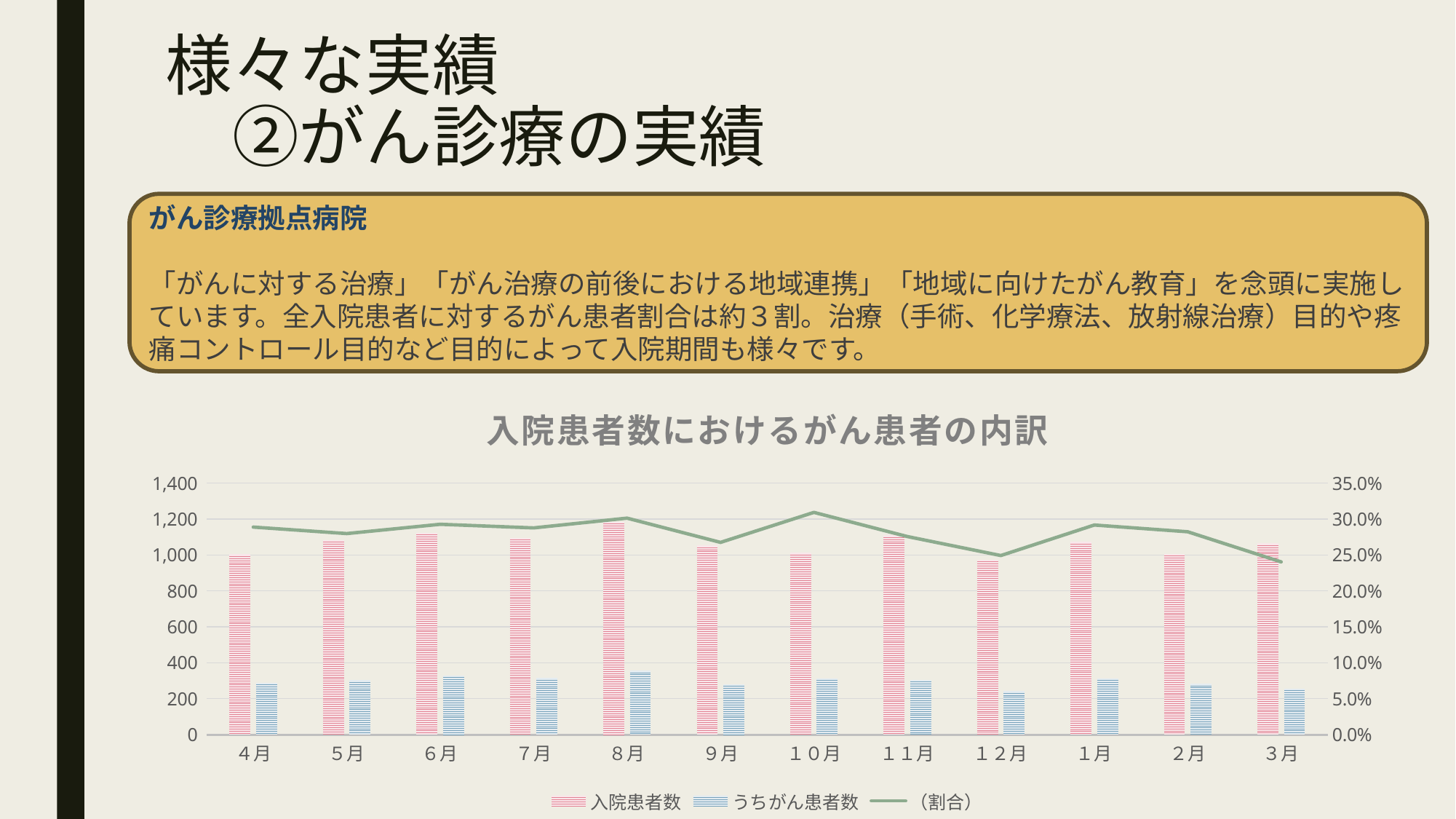
Which month has the larger 入院患者数, 8月 or 12月? 8月 In which month is the （割合） line highest? 10月 How many series does the chart legend list? 3 Which series in the chart is drawn as a line rather than bars? （割合） Is the value of うちがん患者数 for 8月 greater or less than 400? less What kind of chart is shown on the slide? A combined bar and line chart In which month is 入院患者数 highest? 8月 How many months are shown on the x axis of the chart? 12 In which month is うちがん患者数 highest? 8月 Is the value of 入院患者数 for 8月 greater or less than 1,000? greater What is the title of the chart? 入院患者数におけるがん患者の内訳 Is the value of 入院患者数 for 12月 greater or less than 1,000? less